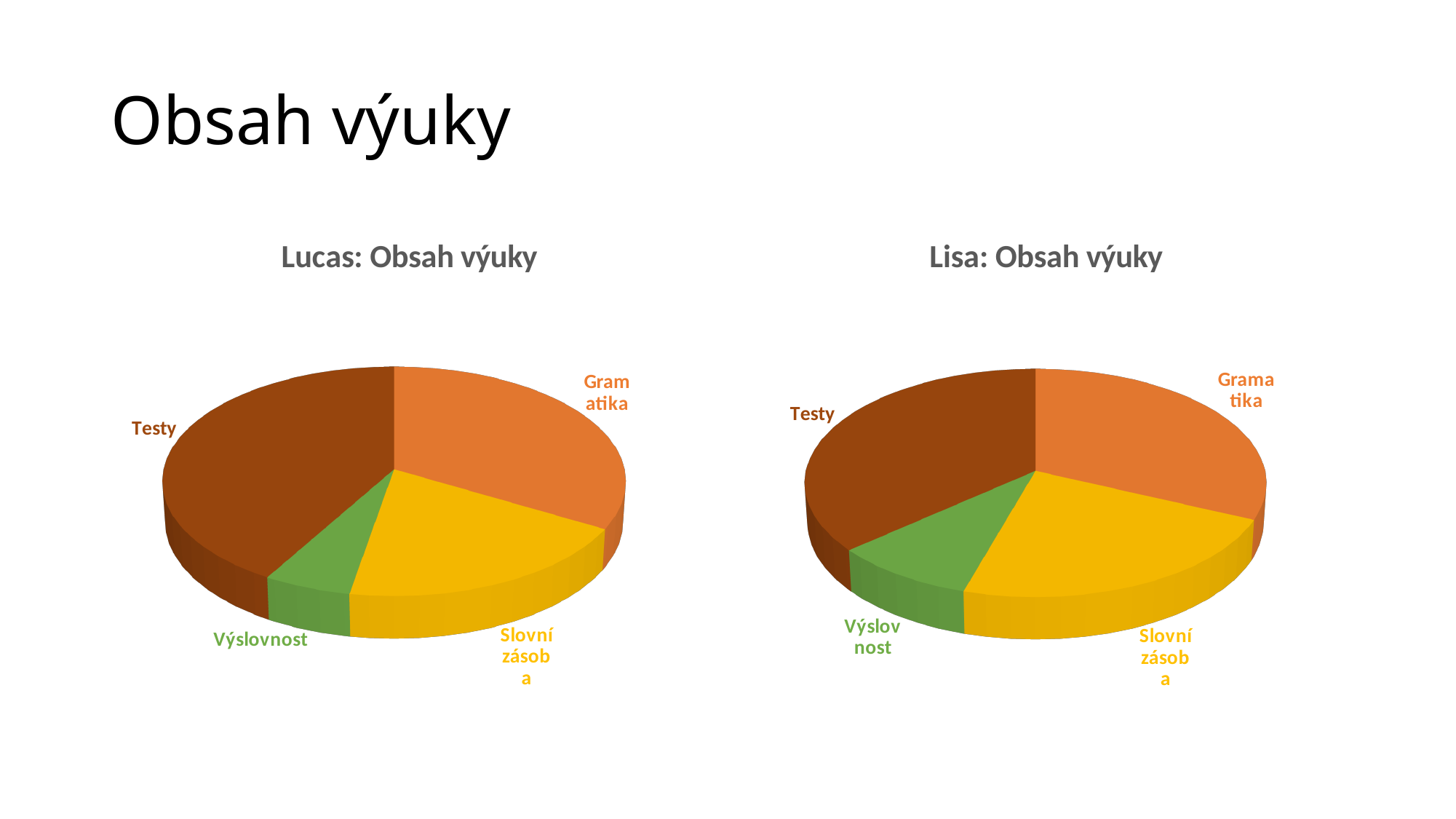
What kind of chart is the "Lisa: Obsah výuky" chart? pie chart In the "Lisa: Obsah výuky" chart, what colour is the Výslovnost slice? green In the "Lucas: Obsah výuky" chart, which category has the smallest slice? Výslovnost In the "Lucas: Obsah výuky" chart, which category has the largest slice? Testy In the "Lisa: Obsah výuky" chart, which slice is larger: Slovní zásoba or Výslovnost? Slovní zásoba What is the title of the pie chart on the left side of the slide? Lucas: Obsah výuky In the "Lisa: Obsah výuky" chart, which slice is larger: Testy or Výslovnost? Testy How many slices does the "Lucas: Obsah výuky" pie chart have? 4 What kind of chart is the "Lucas: Obsah výuky" chart? pie chart In the "Lisa: Obsah výuky" chart, which category has the smallest slice? Výslovnost How many slices does the "Lisa: Obsah výuky" pie chart have? 4 In the "Lucas: Obsah výuky" chart, which slice is larger: Testy or Výslovnost? Testy